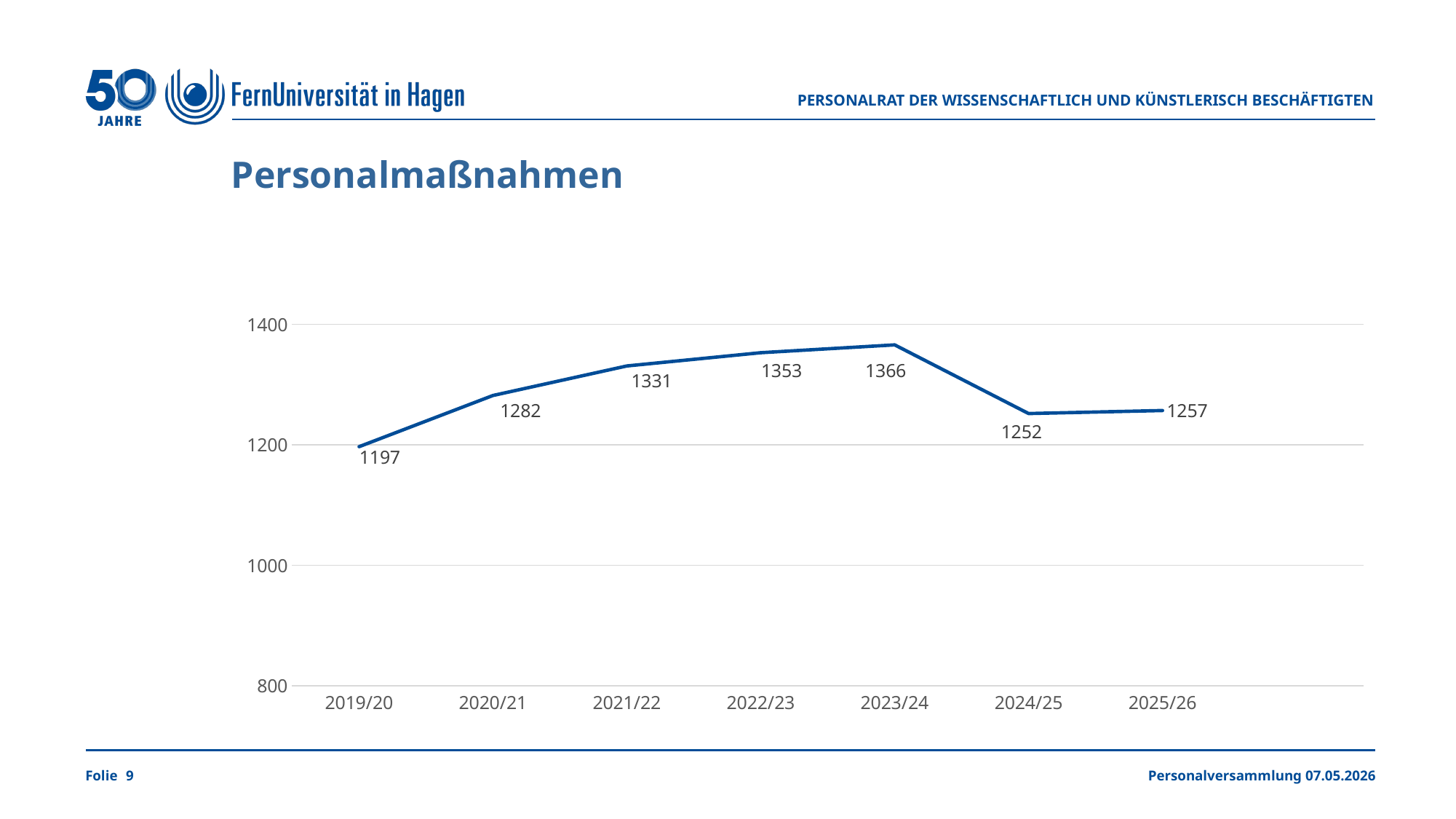
How many years are shown on the x axis? 7 What is the difference between the values for 2020/21 and 2019/20? 85 What is the value for 2025/26? 1257 Is the value for 2022/23 greater or less than 1400? less Which is larger, the value for 2021/22 or the value for 2025/26? 2021/22 What is the value for 2019/20? 1197 Which year has the lowest value? 2019/20 What kind of chart is shown on the slide? line chart Do the values rise or fall from 2019/20 to 2023/24? rise What is the value for 2023/24? 1366 What is the difference between the values for 2023/24 and 2024/25? 114 Which year has the highest value? 2023/24